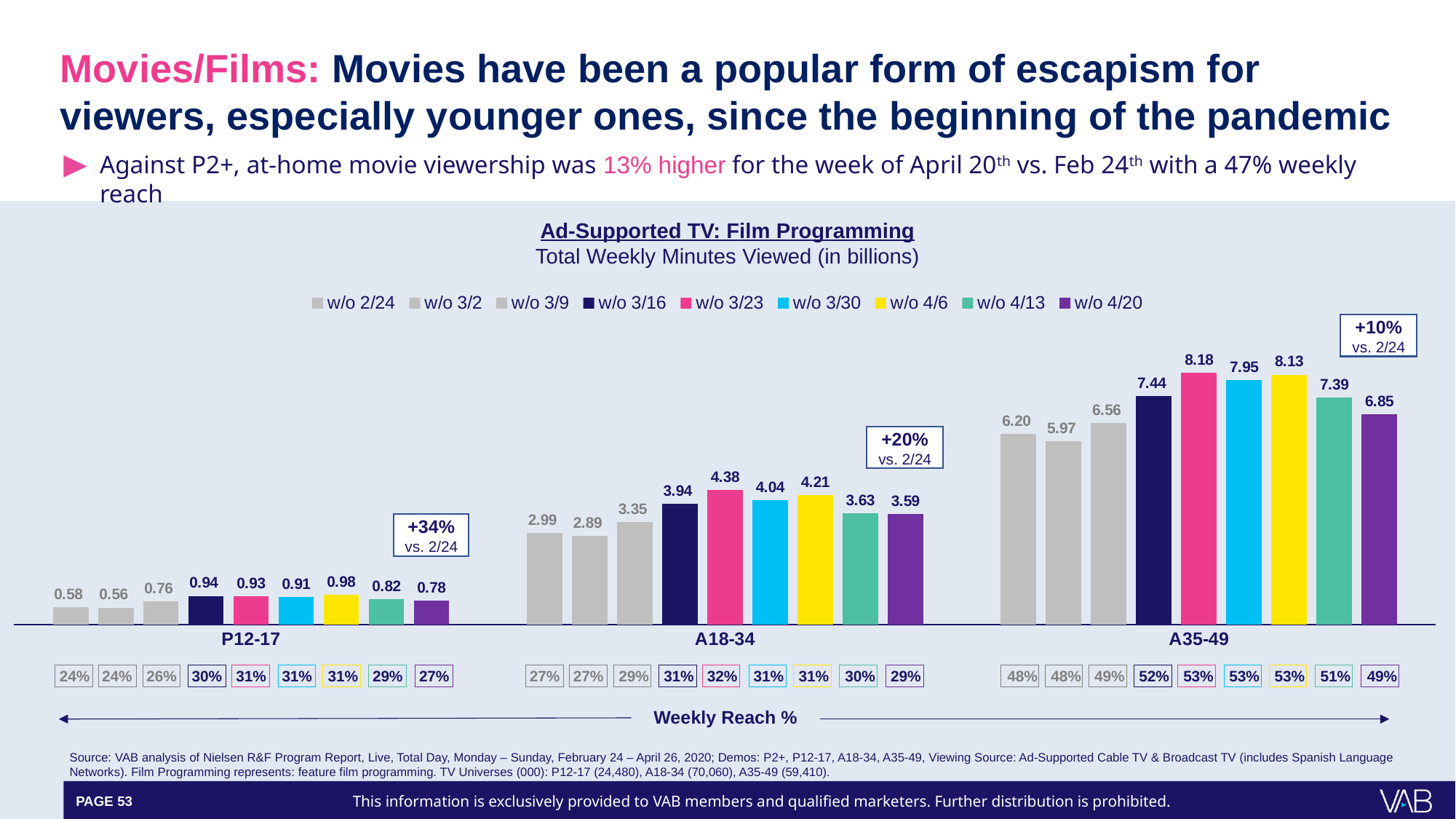
How many series does the legend list? 9 What is the percentage change vs. 2/24 shown in the callout above the A18-34 group? +20% Which week has the highest value in the A18-34 group? w/o 3/23 Which week has the lowest value in the A35-49 group? w/o 3/2 What is the value for w/o 3/23 in the A35-49 group? 8.18 What is the difference between the w/o 3/23 and w/o 2/24 values in the A35-49 group? 1.98 Which is larger in the A18-34 group: the value for w/o 4/6 or the value for w/o 3/30? w/o 4/6 What is the subtitle of the chart describing the unit of measurement? Total Weekly Minutes Viewed (in billions) What kind of chart is shown on the slide? Bar chart What is the value for w/o 2/24 in the A18-34 group? 2.99 How many demographic groups are shown on the x axis? 3 What is the value for w/o 4/20 in the P12-17 group? 0.78